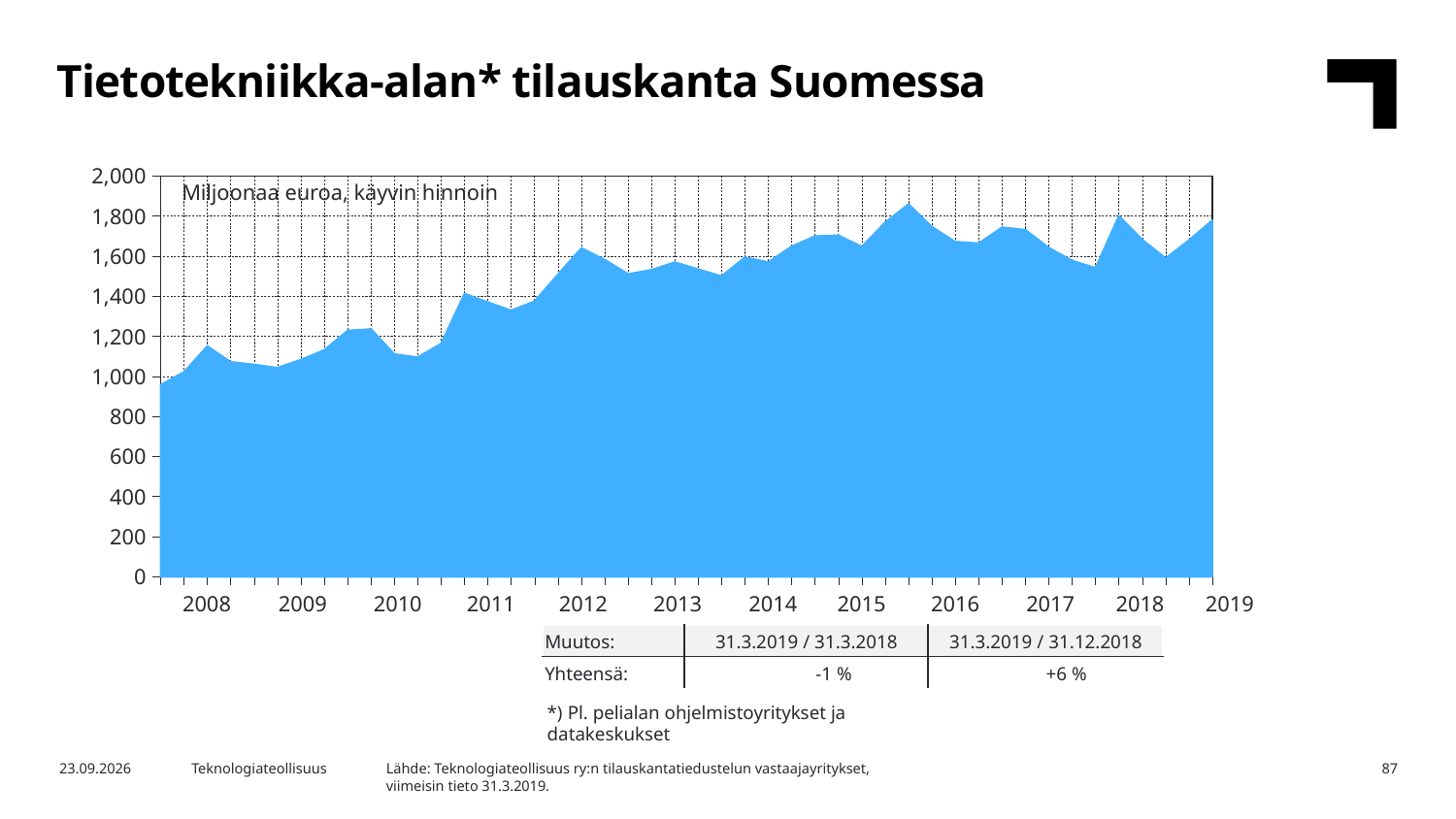
According to the table below the chart, what is the total change (Yhteensä) for 31.3.2019 / 31.3.2018? -1 % Is the value at the start of 2012 greater or less than 1,000? greater Is the value at the start of 2018 greater or less than 1,400? greater Is the value at the start of 2010 greater or less than 1,400? less Which is larger, the value at the start of 2010 or the value at the start of 2014? 2014 What unit is stated inside the chart area? Miljoonaa euroa, käyvin hinnoin Overall, do the values rise or fall from 2008 to 2019? Rise What kind of chart is shown on the slide? Area chart Which is larger, the value at the start of 2008 or the value at the start of 2018? 2018 How many years are labelled on the x axis? 12